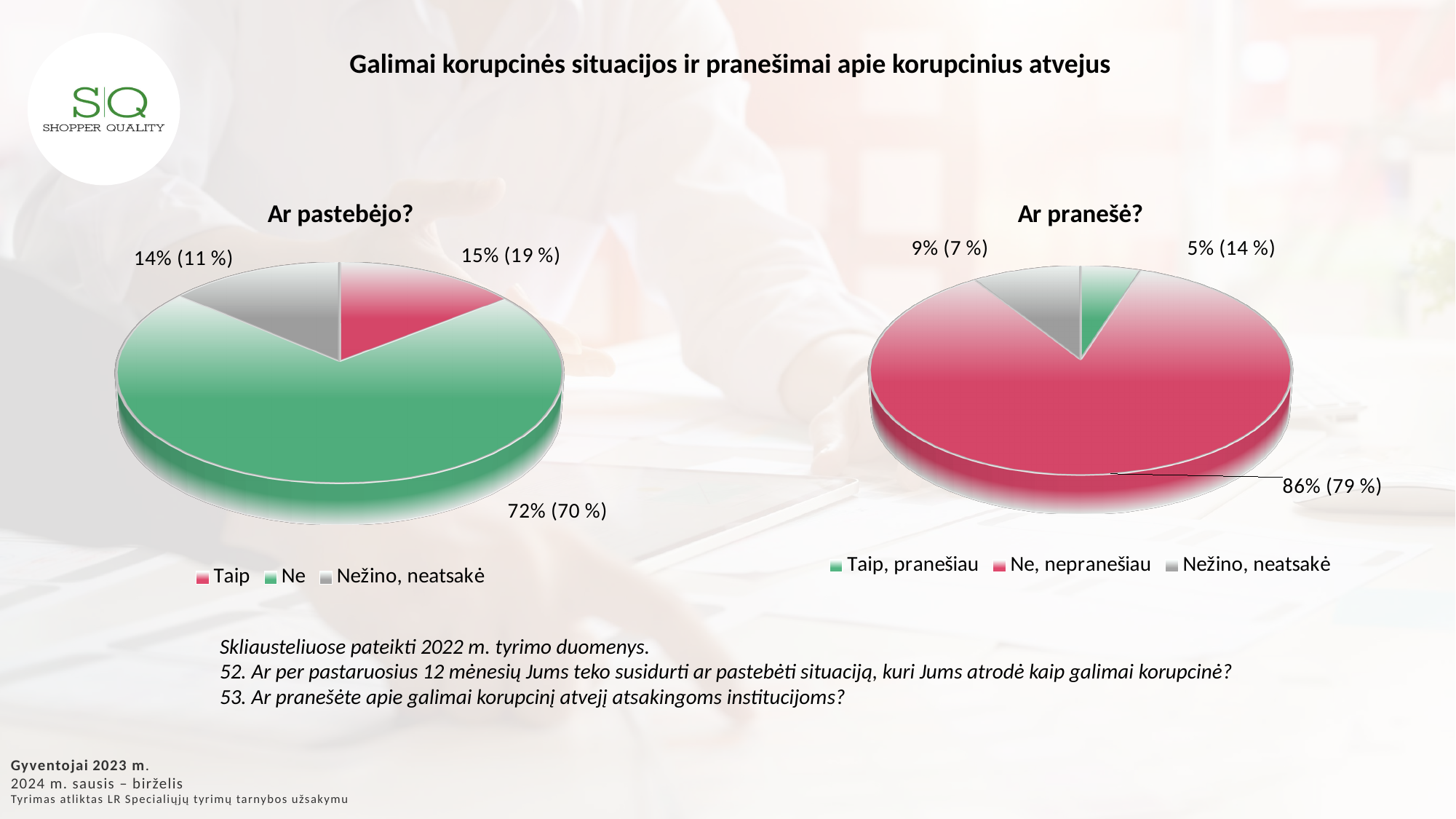
In the 'Ar pastebėjo?' chart, what 2022 value is shown in parentheses for 'Nežino, neatsakė'? 11 % What type of chart is 'Ar pastebėjo?'? Pie chart In the 'Ar pranešė?' chart, which is larger in 2023: 'Taip, pranešiau' or 'Nežino, neatsakė'? Nežino, neatsakė In the 'Ar pastebėjo?' chart, what share is shown for 'Taip' (2023 value, outside the parentheses)? 15% In the 'Ar pastebėjo?' chart, what is the difference between the 2023 shares for 'Ne' and 'Taip'? 57% In the 'Ar pranešė?' chart, what share is shown for 'Taip, pranešiau' (2023 value, outside the parentheses)? 5% In the 'Ar pranešė?' chart, what 2022 value is shown in parentheses for 'Ne, nepranešiau'? 79 % In the 'Ar pastebėjo?' chart, which category has the largest slice? Ne In the 'Ar pranešė?' chart, what share is shown for 'Ne, nepranešiau' (2023 value, outside the parentheses)? 86% How many categories does the legend of the 'Ar pranešė?' chart list? 3 In the 'Ar pranešė?' chart, which category has the smallest slice? Taip, pranešiau In the 'Ar pastebėjo?' chart, what share is shown for 'Ne' (2023 value, outside the parentheses)? 72%